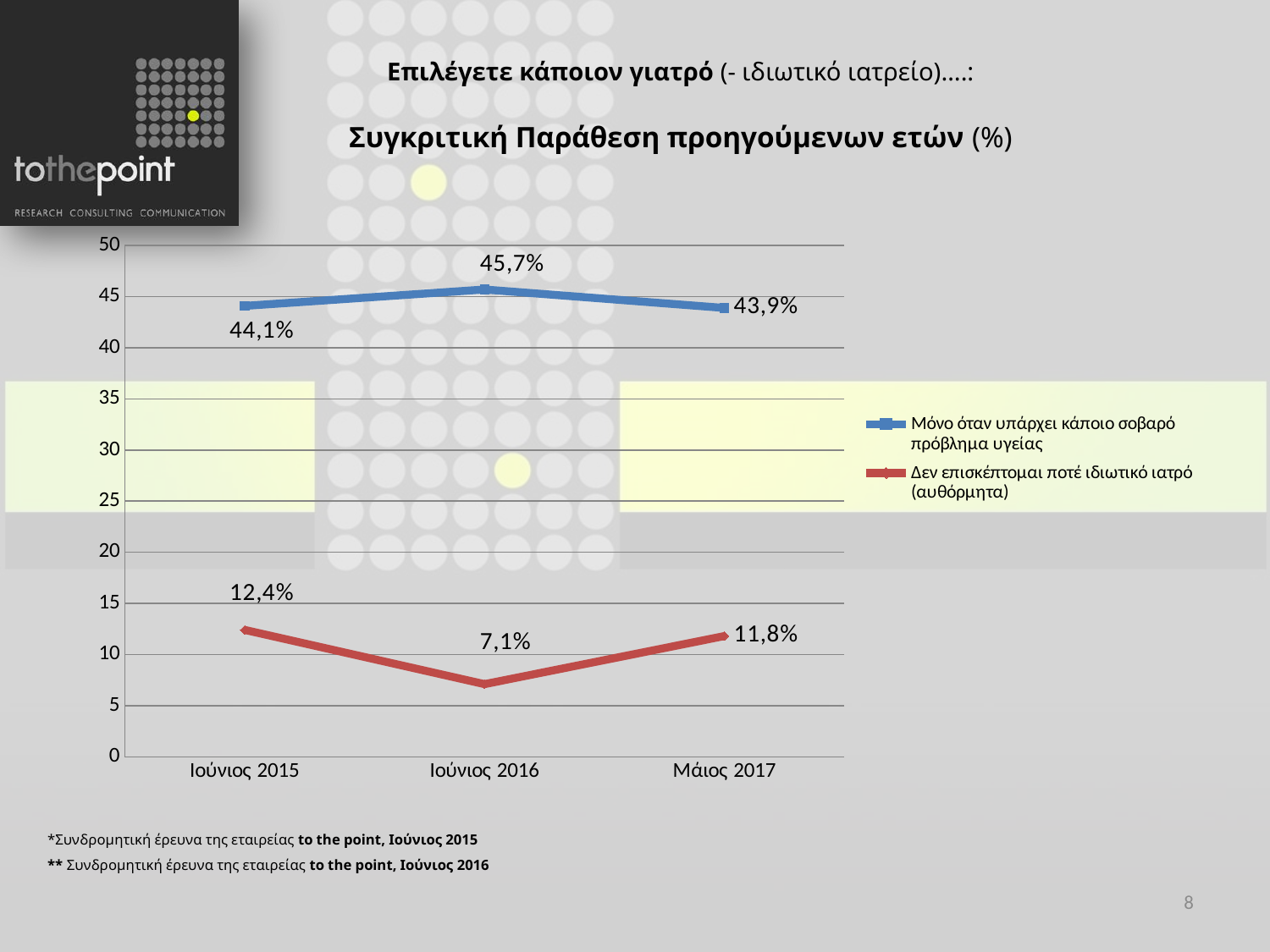
What is the value for 'Δεν επισκέπτομαι ποτέ ιδιωτικό ιατρό (αυθόρμητα)' in Μάιος 2017? 11,8% Which is larger: the 'Μόνο όταν υπάρχει κάποιο σοβαρό πρόβλημα υγείας' value in Ιούνιος 2015 or in Μάιος 2017? Ιούνιος 2015 Is the value for 'Μόνο όταν υπάρχει κάποιο σοβαρό πρόβλημα υγείας' in Μάιος 2017 greater or less than 40? greater Does the 'Δεν επισκέπτομαι ποτέ ιδιωτικό ιατρό (αυθόρμητα)' series rise or fall from Ιούνιος 2016 to Μάιος 2017? Rise What is the value for 'Δεν επισκέπτομαι ποτέ ιδιωτικό ιατρό (αυθόρμητα)' in Ιούνιος 2015? 12,4% In which period is the value for 'Δεν επισκέπτομαι ποτέ ιδιωτικό ιατρό (αυθόρμητα)' lowest? Ιούνιος 2016 In which period is the value for 'Μόνο όταν υπάρχει κάποιο σοβαρό πρόβλημα υγείας' highest? Ιούνιος 2016 How many time periods are shown on the x axis? 3 What is the difference between the 'Δεν επισκέπτομαι ποτέ ιδιωτικό ιατρό (αυθόρμητα)' values for Ιούνιος 2015 and Ιούνιος 2016? 5,3% What is the value for 'Μόνο όταν υπάρχει κάποιο σοβαρό πρόβλημα υγείας' in Ιούνιος 2016? 45,7% How many series does the legend list? 2 What type of chart is shown on the slide? Line chart